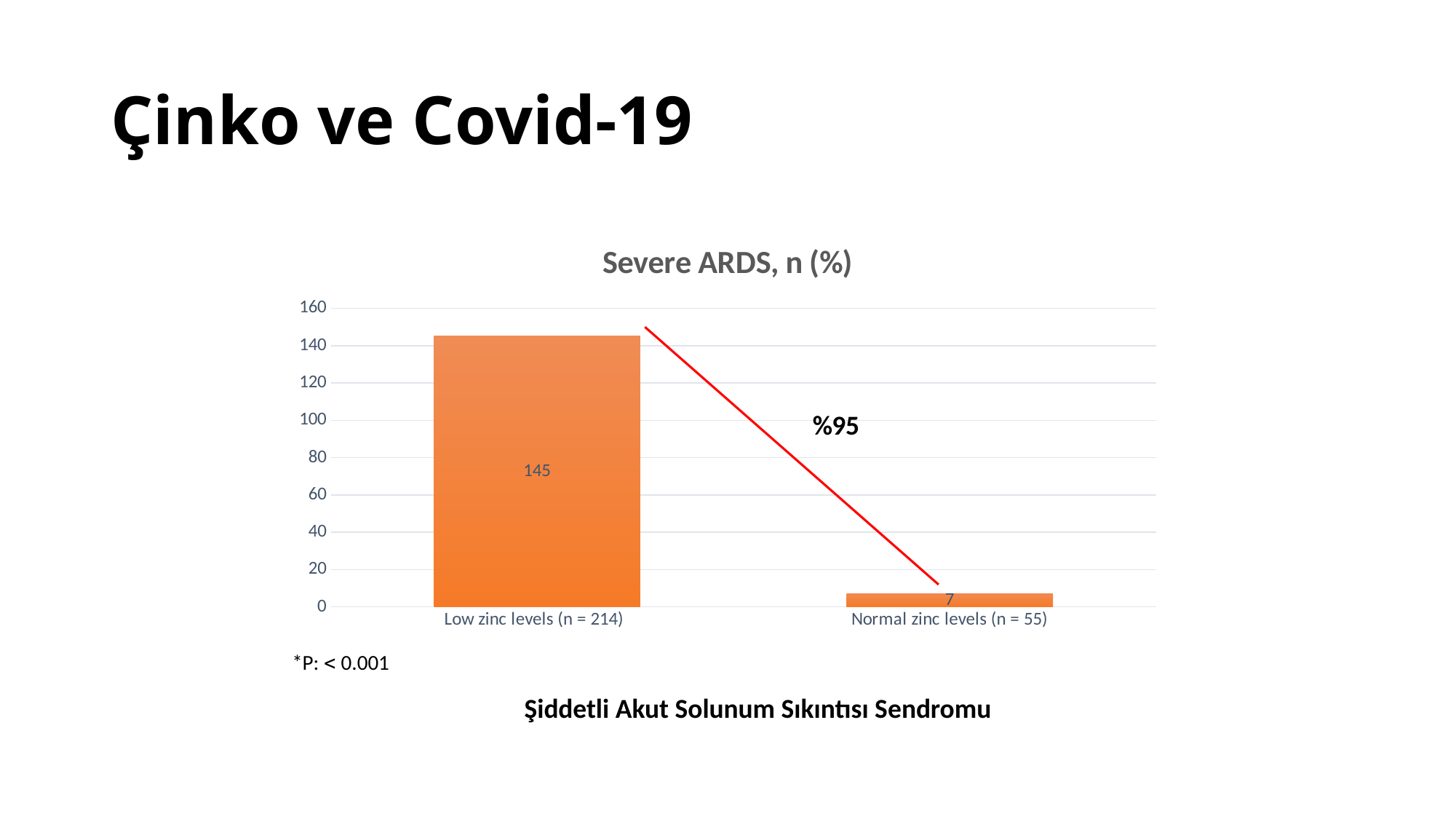
Is the value for Normal zinc levels (n = 55) greater or less than 20? less What is the title of the chart? Severe ARDS, n (%) Which category has the lowest value? Normal zinc levels (n = 55) Is the value for Low zinc levels (n = 214) greater or less than 100? greater Which category has the highest value? Low zinc levels (n = 214) What is the difference between the values for Low zinc levels (n = 214) and Normal zinc levels (n = 55)? 138 What is the value for Low zinc levels (n = 214)? 145 Which is larger, the value for Low zinc levels (n = 214) or Normal zinc levels (n = 55)? Low zinc levels (n = 214) What is the value for Normal zinc levels (n = 55)? 7 How many categories are shown on the chart? 2 What percentage is written next to the red line on the chart? %95 What kind of chart is shown on the slide? bar chart